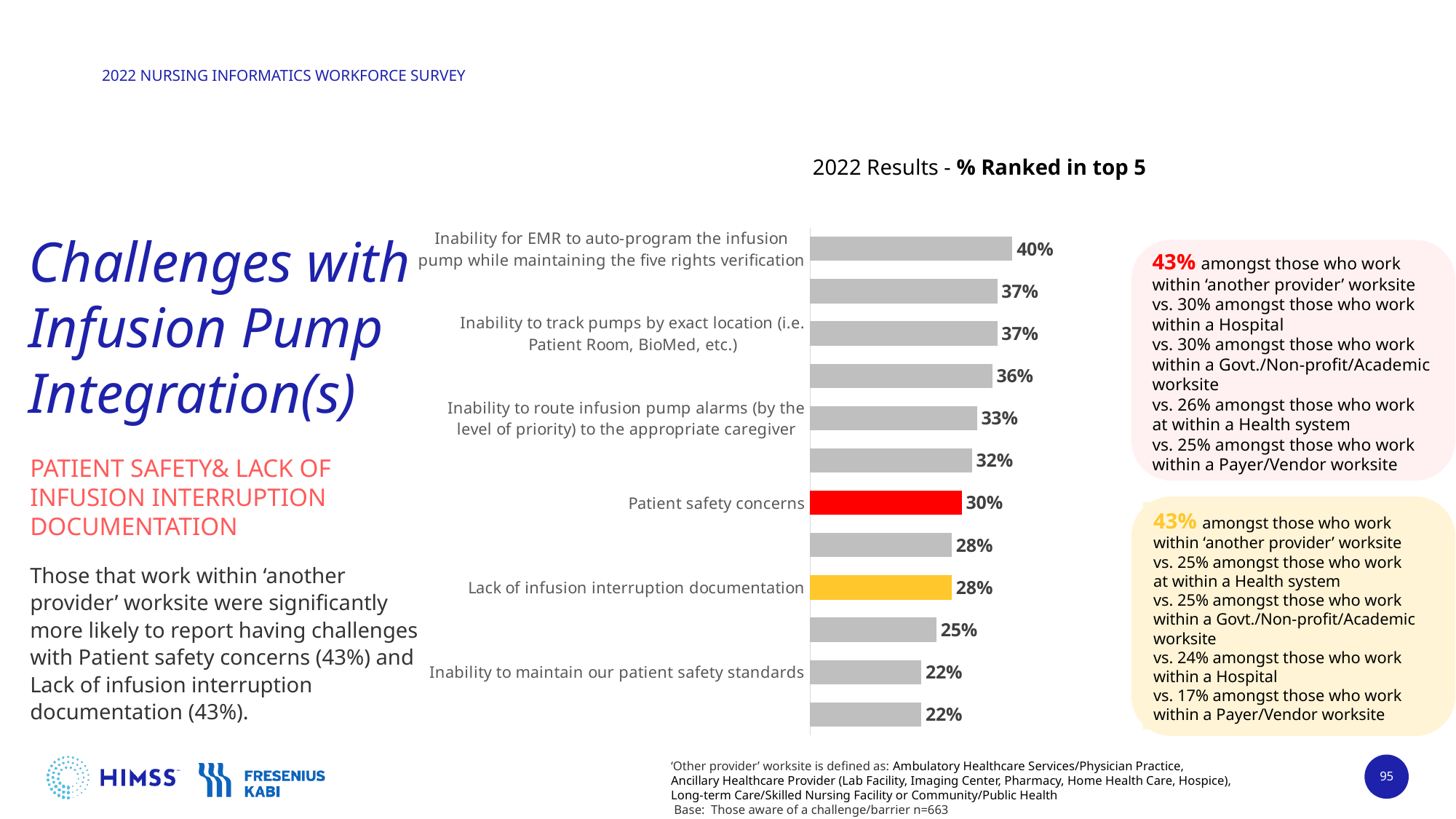
What is the value shown for 'Lack of infusion interruption documentation'? 28% What is the value for 'Inability to maintain our patient safety standards'? 22% How many bars are plotted on the chart? 12 Which challenge has the highest percentage ranked in the top 5? Inability for EMR to auto-program the infusion pump while maintaining the five rights verification What type of chart is shown on the slide? Bar chart What colour is the bar for 'Patient safety concerns'? Red What is the difference between the values for 'Patient safety concerns' and 'Lack of infusion interruption documentation'? 2 percentage points Which has a larger value: 'Inability to track pumps by exact location' or 'Inability to route infusion pump alarms'? Inability to track pumps by exact location What is the lowest value shown on the chart? 22% What is the value for 'Inability to route infusion pump alarms (by the level of priority) to the appropriate caregiver'? 33% What percentage ranked 'Patient safety concerns' in their top 5? 30% What is the value for 'Inability to track pumps by exact location (i.e. Patient Room, BioMed, etc.)'? 37%